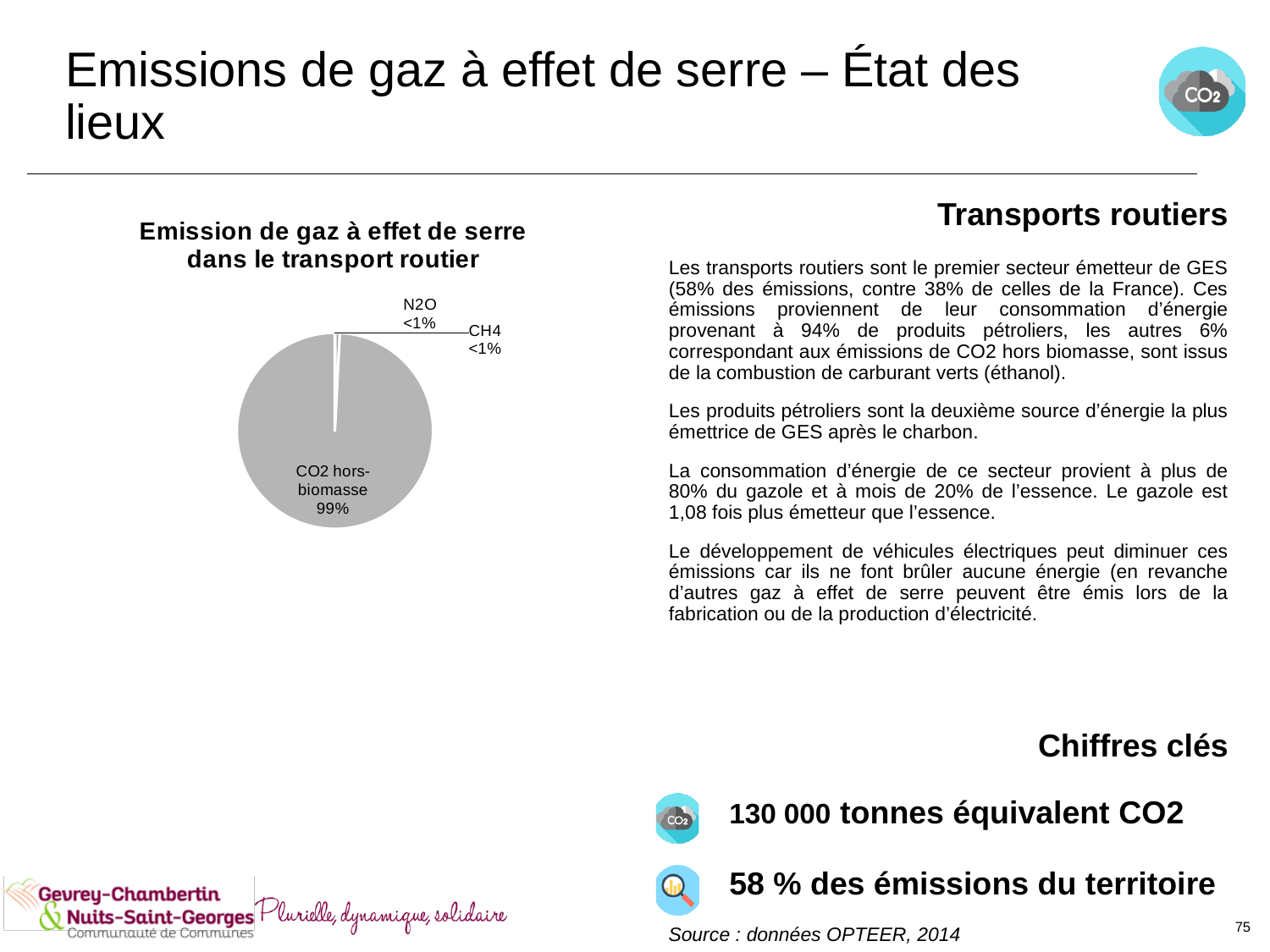
What value is shown for N2O in the pie chart? <1% Which is larger in the pie chart, CO2 hors-biomasse or CH4? CO2 hors-biomasse What is the title of the chart? Emission de gaz à effet de serre dans le transport routier Which category has the largest slice of the pie? CO2 hors-biomasse What colour is the CO2 hors-biomasse slice of the pie? grey How many categories are shown in the pie chart? 3 Which is larger in the pie chart, CO2 hors-biomasse or N2O? CO2 hors-biomasse What value is shown for CH4 in the pie chart? <1% Is the share for CO2 hors-biomasse greater or less than 50%? greater What share of the pie does CO2 hors-biomasse represent? 99% What kind of chart is shown on the slide? pie chart